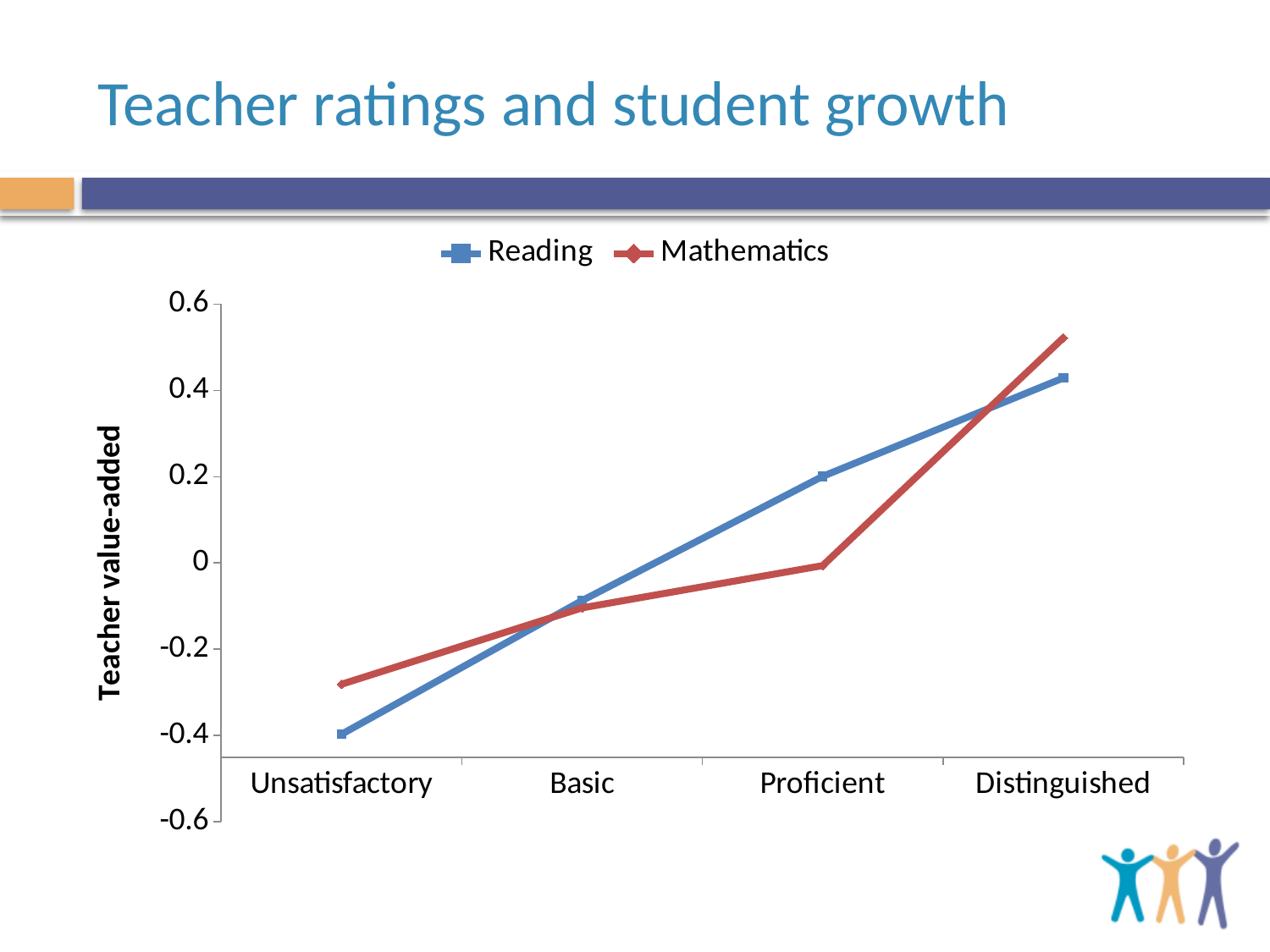
Do the Reading values rise or fall as the rating moves from Unsatisfactory to Distinguished? rise Is the Reading value for Unsatisfactory greater or less than -0.2? less Is the Mathematics value for Distinguished greater or less than 0.4? greater At the Proficient rating, which series has the higher value, Reading or Mathematics? Reading What is the title of the vertical axis? Teacher value-added How many series does the legend list? 2 At the Distinguished rating, which series has the higher value, Reading or Mathematics? Mathematics For which rating category is the Reading value lowest? Unsatisfactory For which rating category is the Mathematics value highest? Distinguished What kind of chart is shown on the slide? line chart For which rating category is the Reading value highest? Distinguished How many teacher rating categories are shown on the x axis? 4